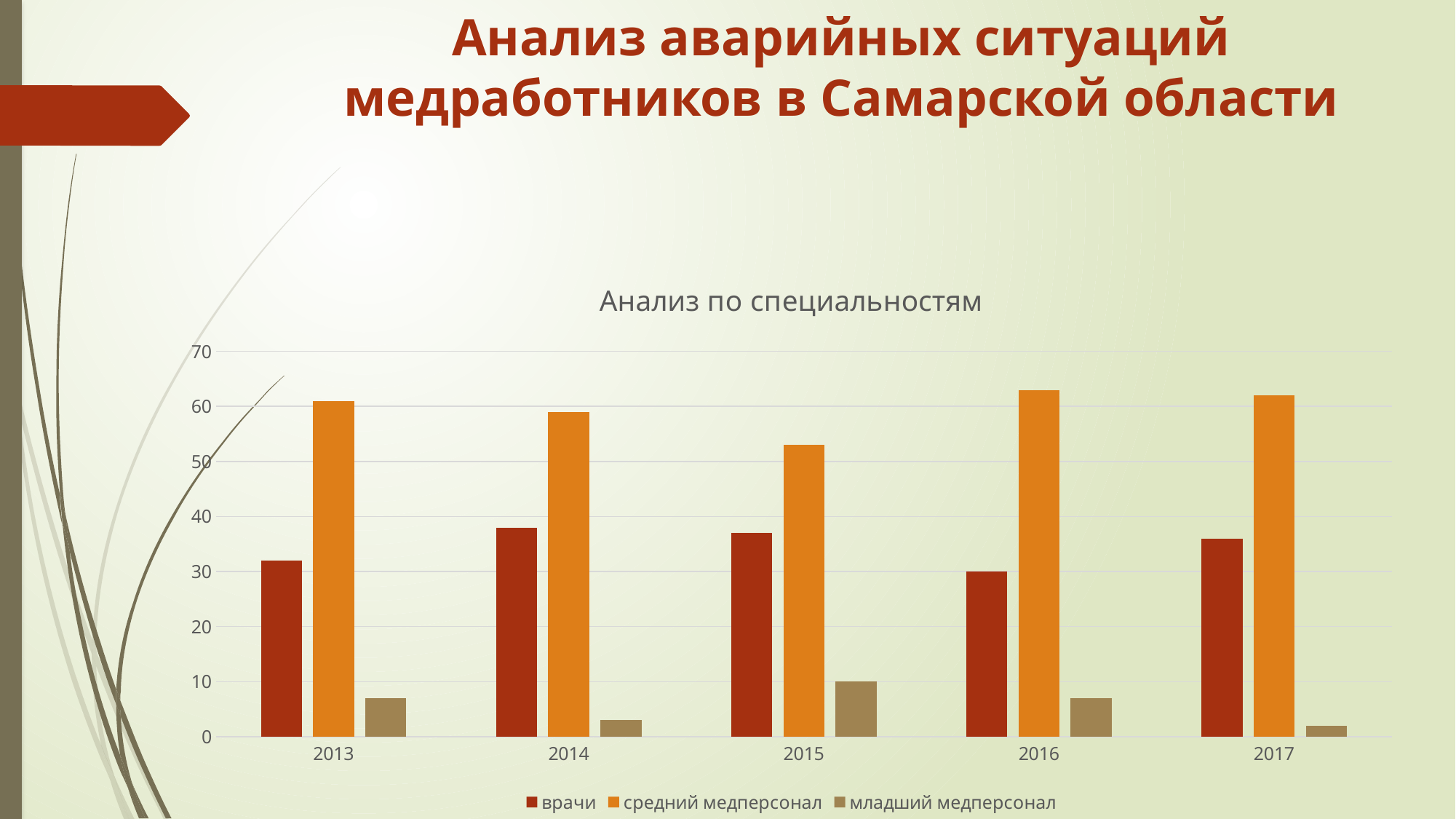
Is the value for средний медперсонал in 2016 greater or less than 60? greater In 2013, which is larger: врачи or средний медперсонал? средний медперсонал How many series does the legend list? 3 Is the value for младший медперсонал in 2014 greater or less than 10? less Is the value for средний медперсонал in 2015 greater or less than 60? less What is the title of the chart? Анализ по специальностям In which year is the value for средний медперсонал the lowest? 2015 Which series is shown in orange? средний медперсонал In which year is the value for младший медперсонал the highest? 2015 What kind of chart is shown on the slide? bar chart How many years are shown on the x axis? 5